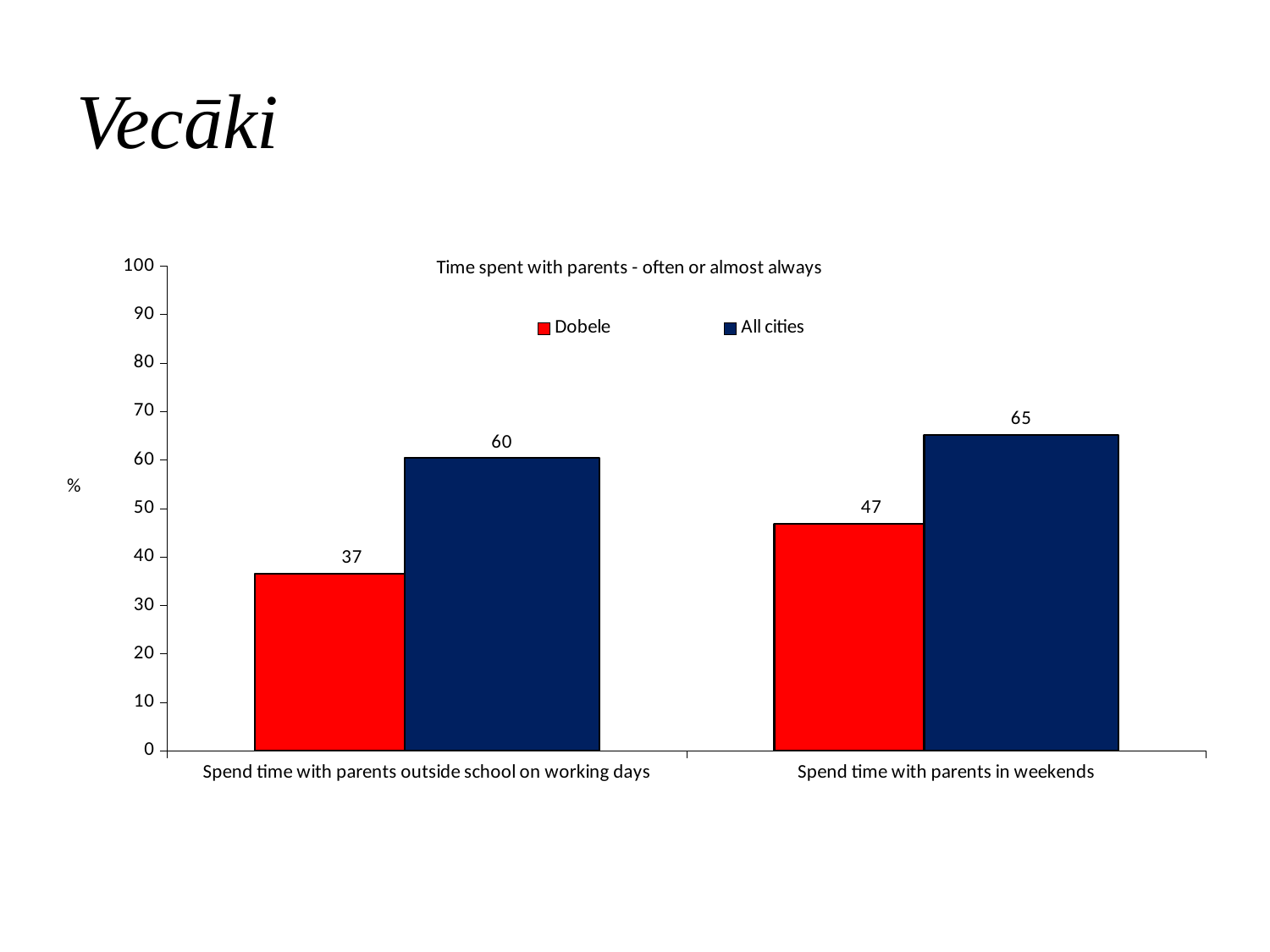
What is the value for Dobele for 'Spend time with parents in weekends'? 47 What is the title of the chart? Time spent with parents - often or almost always Which category has the highest value for Dobele? Spend time with parents in weekends What kind of chart is shown on the slide? Bar chart What is the difference between All cities and Dobele for 'Spend time with parents in weekends'? 18 What is the value for All cities for 'Spend time with parents outside school on working days'? 60 Which category has the lowest value for All cities? Spend time with parents outside school on working days How many series does the legend list? 2 What is the value for All cities for 'Spend time with parents in weekends'? 65 What is the difference between All cities and Dobele for 'Spend time with parents outside school on working days'? 23 Which is larger for 'Spend time with parents in weekends': Dobele or All cities? All cities What is the value for Dobele for 'Spend time with parents outside school on working days'? 37